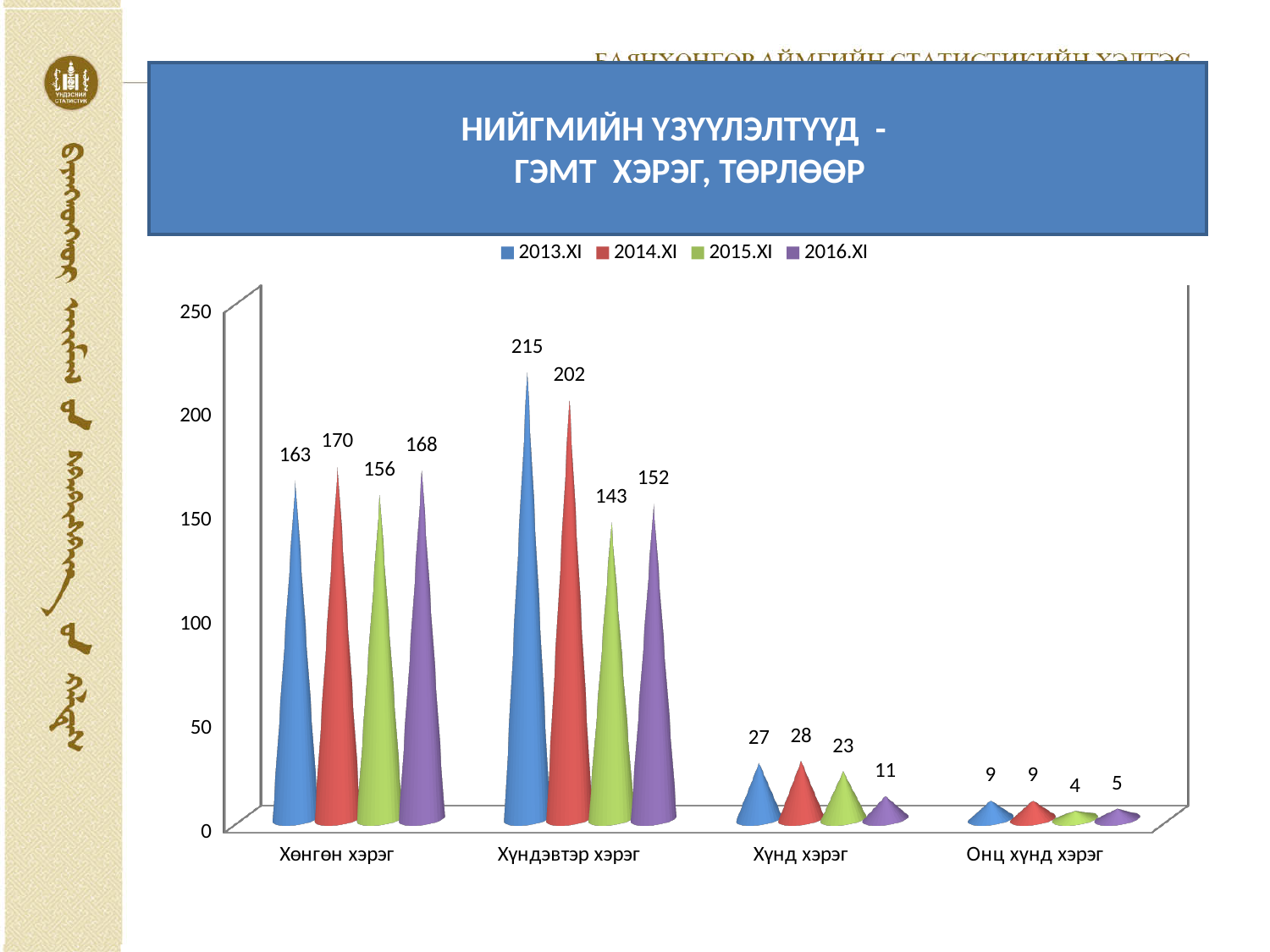
Which series is shown in red in the legend? 2014.XI What is the difference between the 2013.XI and 2015.XI values for Хүндэвтэр хэрэг? 72 Which category has the highest value in the 2014.XI series? Хүндэвтэр хэрэг How many series does the legend list? 4 What is the value for Онц хүнд хэрэг in the 2015.XI series? 4 What is the value for Хүндэвтэр хэрэг in the 2013.XI series? 215 What is the value for Хөнгөн хэрэг in the 2015.XI series? 156 Which category has the lowest value in the 2016.XI series? Онц хүнд хэрэг What is the value for Хүнд хэрэг in the 2016.XI series? 11 Which is larger for Хөнгөн хэрэг: the 2014.XI value or the 2016.XI value? 2014.XI How many categories are shown on the x axis? 4 What kind of chart is shown on the slide? Bar chart